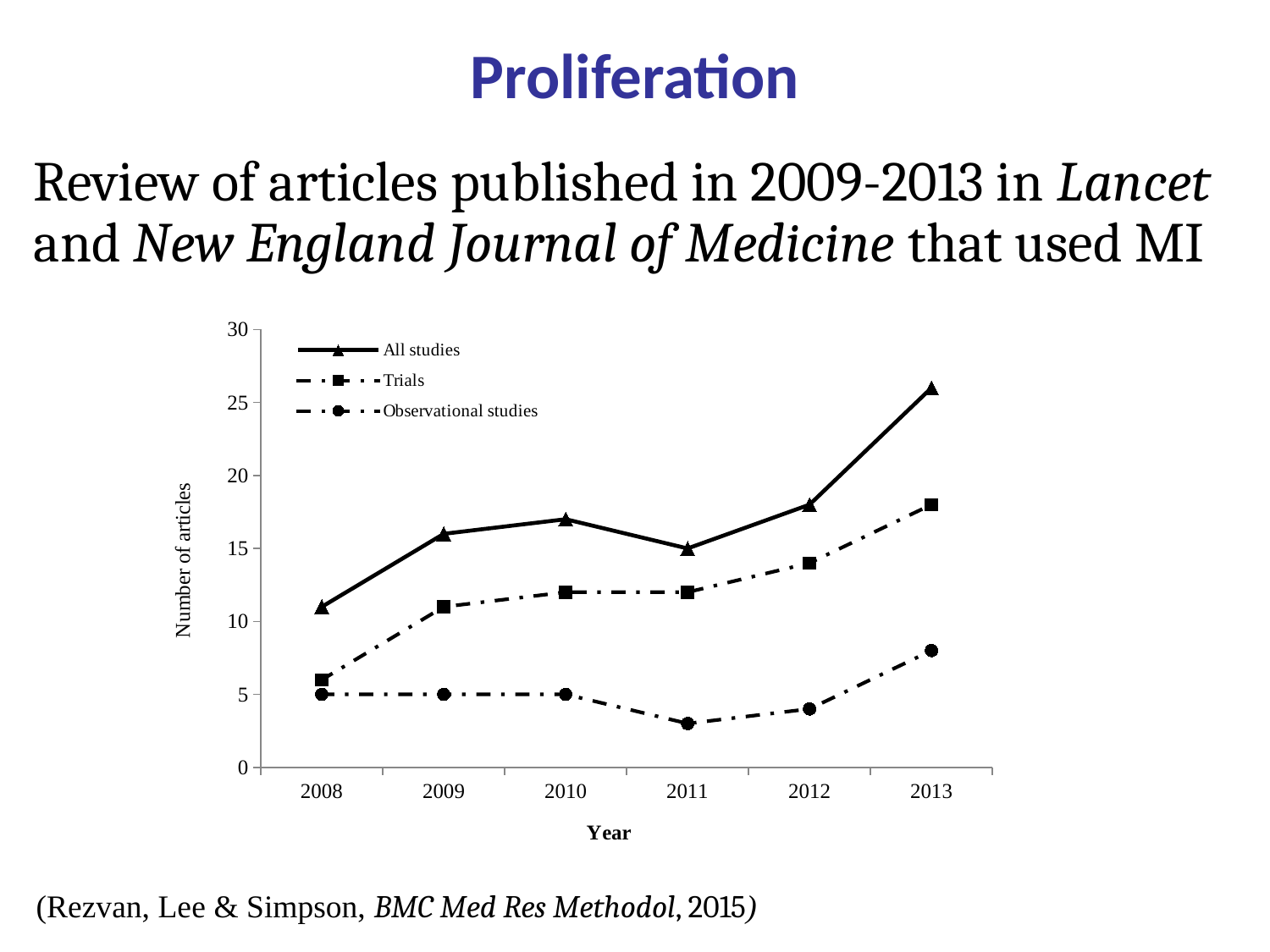
Which is larger in 2013, the value for All studies or the value for Trials? All studies Is the value for All studies in 2012 greater or less than 20? less What kind of chart is shown on the slide? line chart Is the value for Observational studies in 2011 greater or less than 5? less Does the value for All studies rise or fall from 2008 to 2013 overall? rise How many years are plotted along the x axis? 6 What is the label on the y axis? Number of articles Is the value for All studies in 2013 greater or less than 25? greater In which year is the value for Observational studies lowest? 2011 In which year is the value for All studies highest? 2013 How many series does the legend list? 3